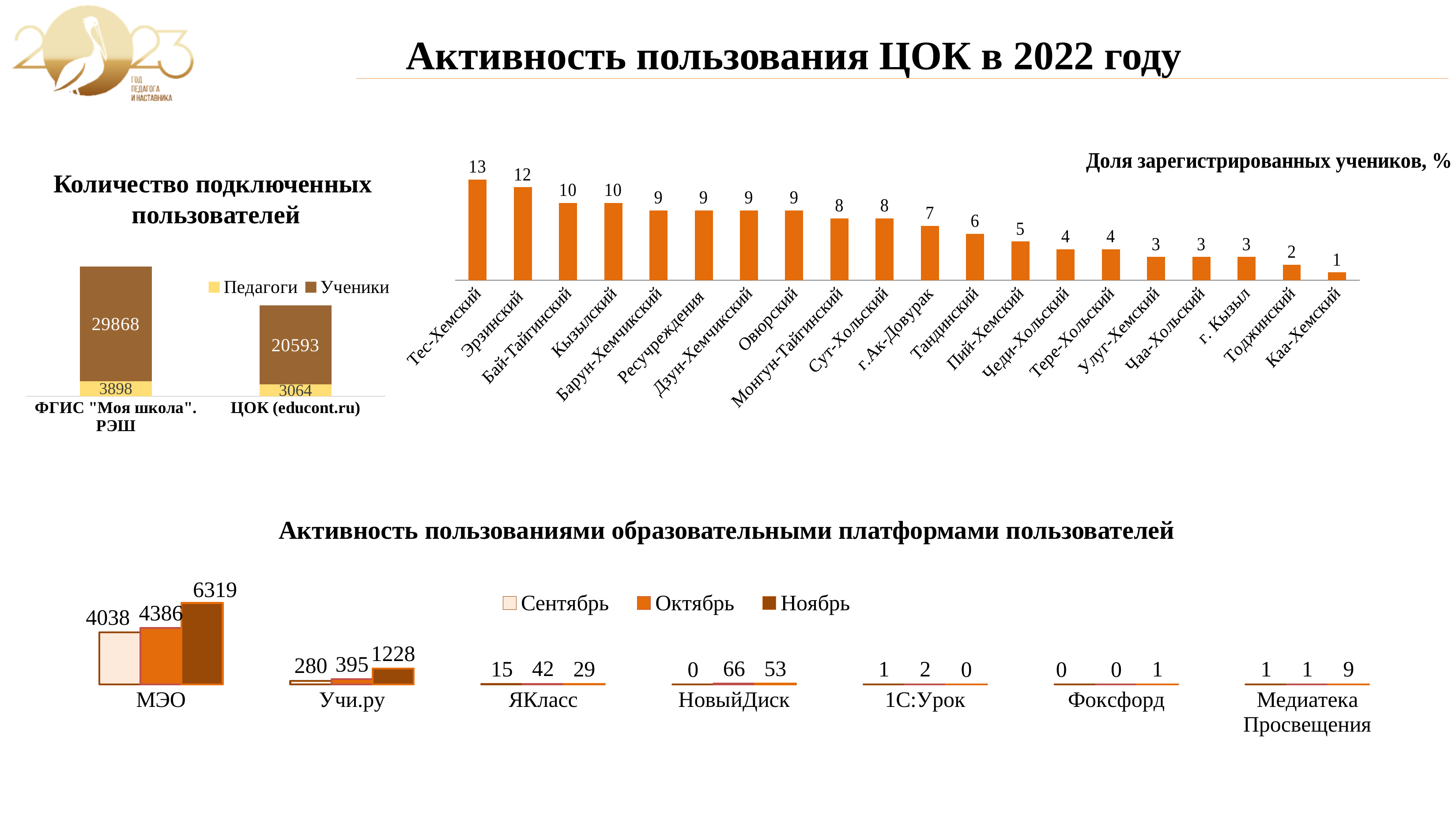
In the chart "Количество подключенных пользователей", how many series does the legend list? 2 In the chart "Доля зарегистрированных учеников, %", how many categories are shown? 20 In the chart "Количество подключенных пользователей", what is the value for Педагоги at ЦОК (educont.ru)? 3064 In the chart "Количество подключенных пользователей", what is the total of the stacked bar for ЦОК (educont.ru)? 23657 In the chart "Доля зарегистрированных учеников, %", which category has the highest value? Тес-Хемский In the chart "Активность пользованиями образовательными платформами пользователей", what is the difference between Ноябрь and Сентябрь at МЭО? 2281 In the chart "Активность пользованиями образовательными платформами пользователей", which is larger at НовыйДиск: Октябрь or Ноябрь? Октябрь In the chart "Доля зарегистрированных учеников, %", which category has the lowest value? Каа-Хемский In the chart "Доля зарегистрированных учеников, %", do the values rise or fall from left to right? fall In the chart "Доля зарегистрированных учеников, %", what is the value for Тандинский? 6 In the chart "Количество подключенных пользователей", what is the value for Ученики at ФГИС "Моя школа". РЭШ? 29868 In the chart "Активность пользованиями образовательными платформами пользователей", what is the value for Ноябрь at Учи.ру? 1228